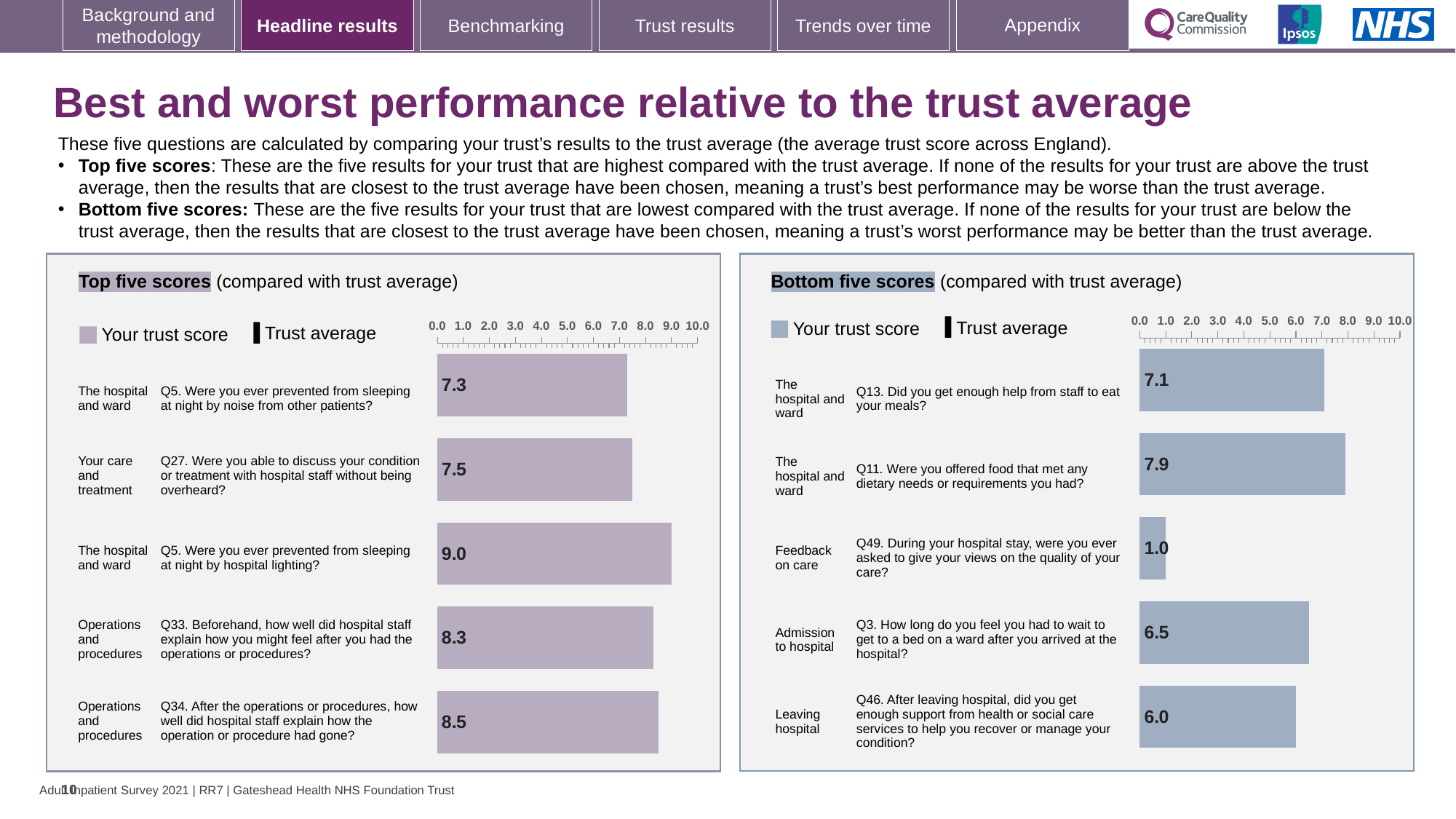
In the Bottom five scores chart, which has the larger score: Q3 about waiting for a bed or Q46 about support after leaving hospital? Q3 How many entries does the legend of the Top five scores chart list? 2 In the Bottom five scores chart, what is the difference between the scores for Q11 and Q46? 1.9 In the Bottom five scores chart, what is the trust score for Q13 about getting enough help from staff to eat your meals? 7.1 In the Top five scores chart, which question has the highest trust score? Q5. Were you ever prevented from sleeping at night by hospital lighting? What type of chart is used in the Bottom five scores panel? Bar chart How many questions are shown in the Top five scores chart? 5 In the Top five scores chart, what is the trust score for Q27 about discussing your condition or treatment without being overheard? 7.5 In the Top five scores chart, what is the trust score for Q5 about being prevented from sleeping at night by noise from other patients? 7.3 In the Bottom five scores chart, which question has the highest trust score? Q11. Were you offered food that met any dietary needs or requirements you had? In the Top five scores chart, what is the difference between the scores for Q34 and Q33? 0.2 In the Bottom five scores chart, which question has the lowest trust score? Q49. During your hospital stay, were you ever asked to give your views on the quality of your care?